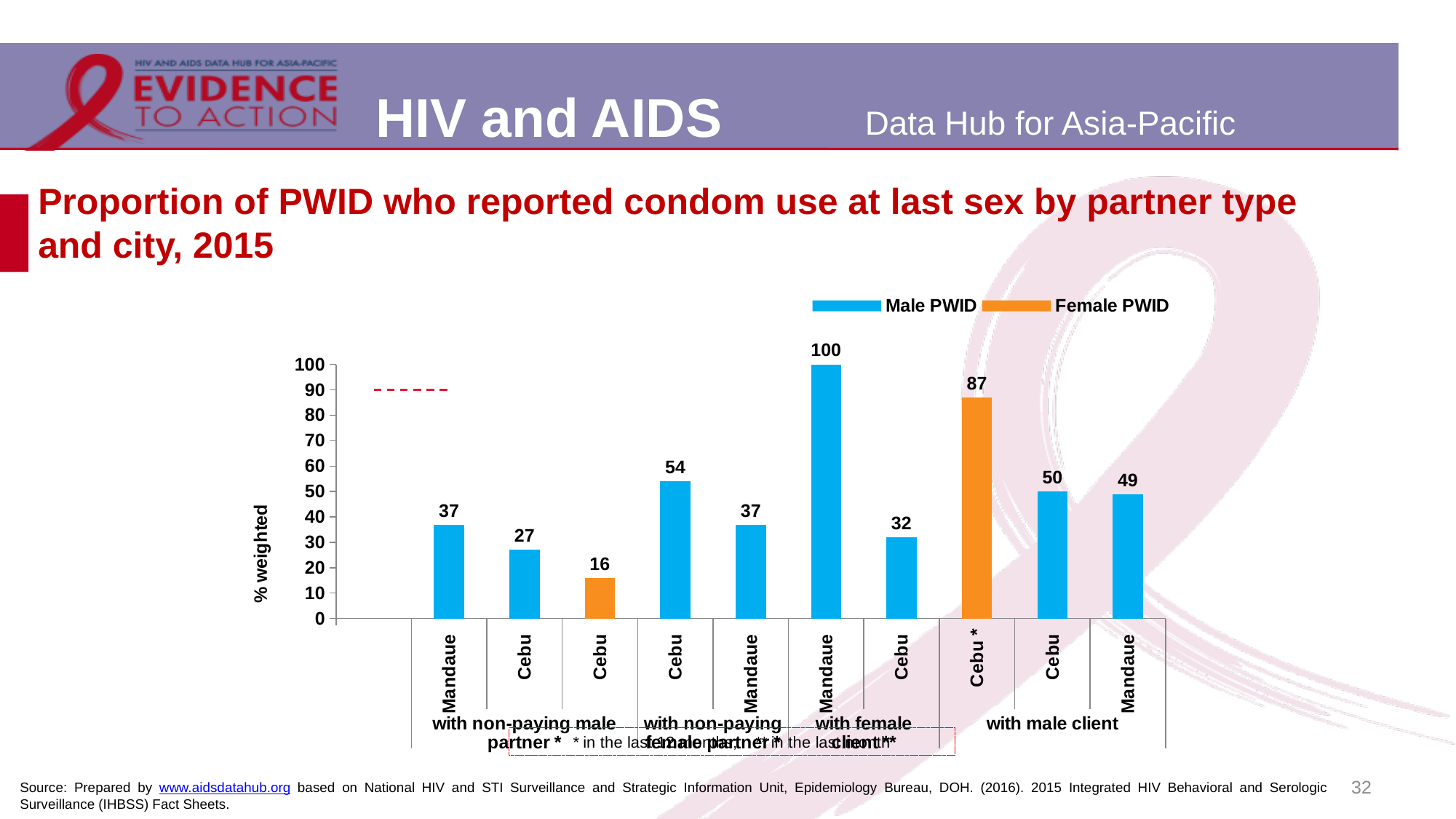
What is the value for Male PWID in Cebu with non-paying female partner? 54 Which bar has the highest value in the chart? Mandaue with female client (Male PWID), 100 Among Male PWID with non-paying female partner, which city has the larger value, Cebu or Mandaue? Cebu Which bar has the lowest value in the chart? Cebu with non-paying male partner (Female PWID), 16 What is the value for Female PWID in Cebu with non-paying male partner? 16 What type of chart is shown on the slide? bar chart What is the difference between the two Female PWID bars (Cebu with male client and Cebu with non-paying male partner)? 71 What is the value for Male PWID in Mandaue with female client? 100 How many bars are plotted in the chart? 10 What is the value for Female PWID in Cebu with male client? 87 How many series does the legend list? 2 What is the label of the vertical axis? % weighted